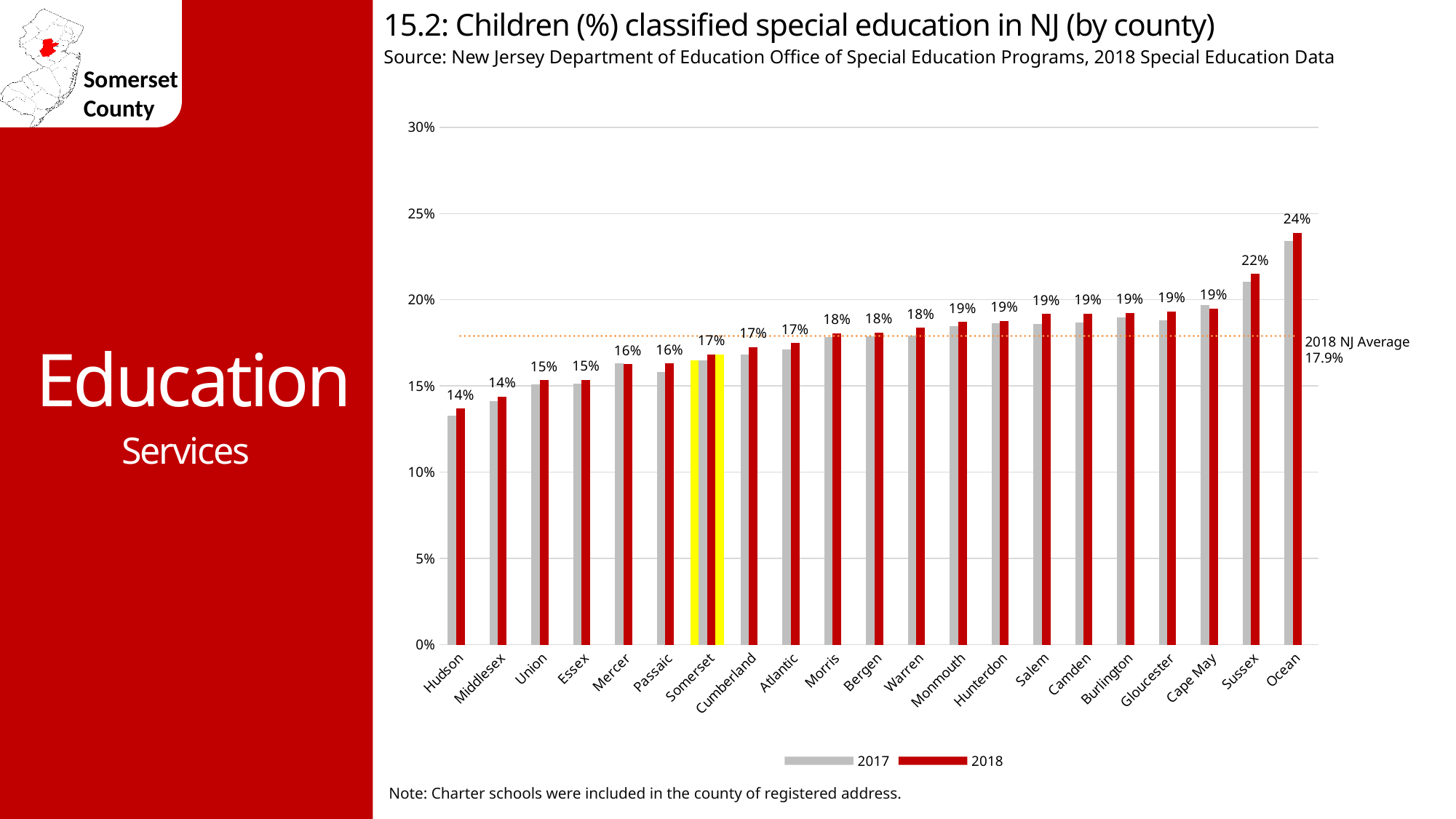
What is the 2018 NJ average shown by the dotted line? 17.9% How many counties are shown on the x axis? 21 What kind of chart is shown? Bar chart What is the 2018 value for Sussex? 22% Which county has the highest 2018 value? Ocean Is the 2017 value for Hudson greater or less than 15%? less Which has a larger 2018 value, Sussex or Mercer? Sussex How many series does the legend list? 2 What is the 2018 value for Somerset? 17% What is the difference between the 2018 values for Ocean and Hudson? 10 percentage points Is the 2017 value for Ocean greater or less than 20%? greater What is the 2018 value for Ocean? 24%